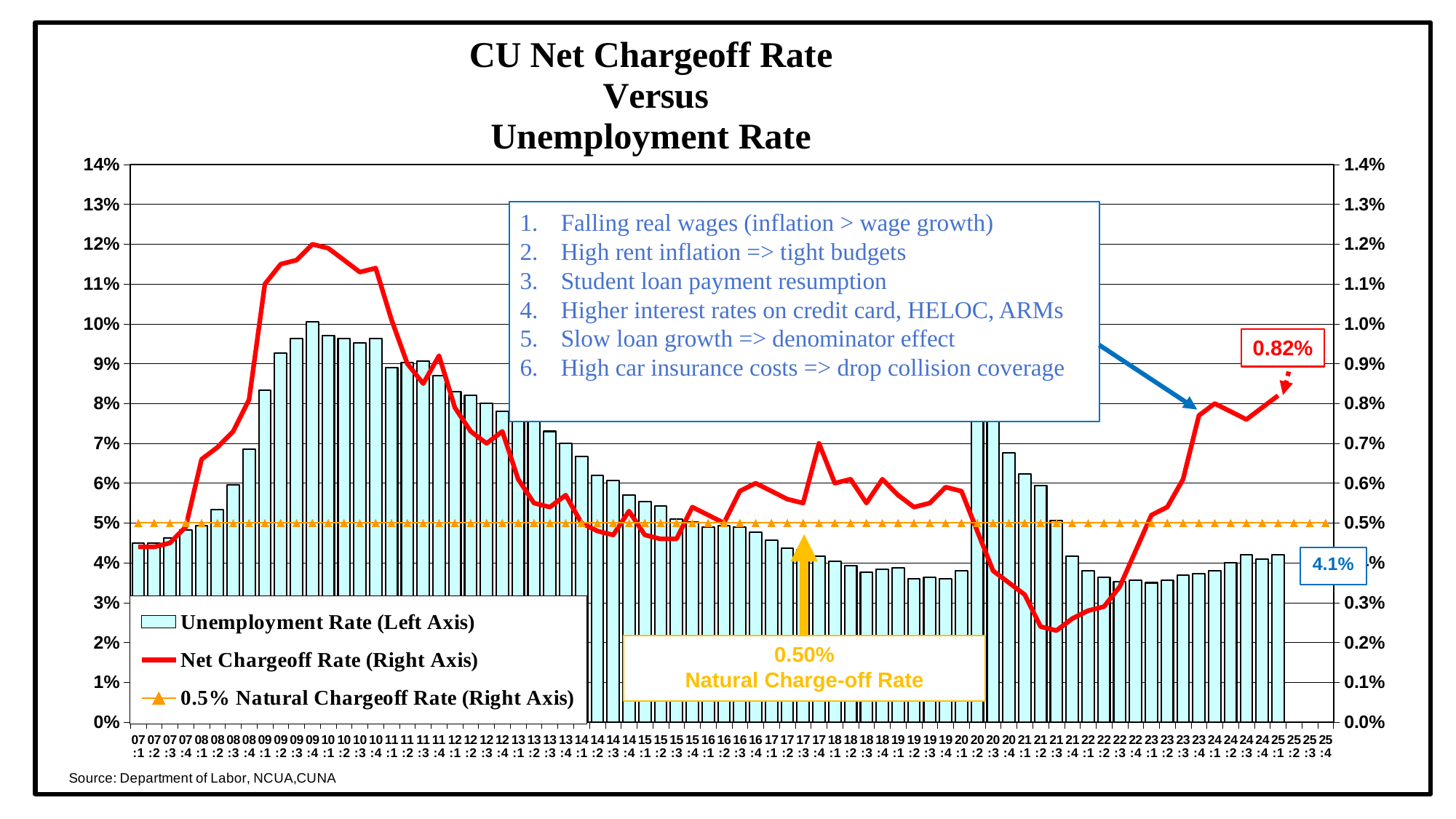
What kind of chart is this? Combination bar and line chart Is the net chargeoff rate for 09:4 greater or less than 1.1%? greater What is the most recent net chargeoff rate value labeled on the chart? 0.82% What is the title of the chart? CU Net Chargeoff Rate Versus Unemployment Rate What value is given for the natural charge-off rate? 0.50% Is the unemployment rate for 09:4 greater or less than 9%? greater Which is larger, the unemployment rate for 09:4 or for 19:4? 09:4 Does the unemployment rate rise or fall from 10:1 to 19:4? fall What is the most recent unemployment rate value labeled on the chart? 4.1% How many series does the legend list? 3 In which quarter does the net chargeoff rate reach its highest point? 09:4 Is the net chargeoff rate for 21:3 greater or less than 0.3%? less